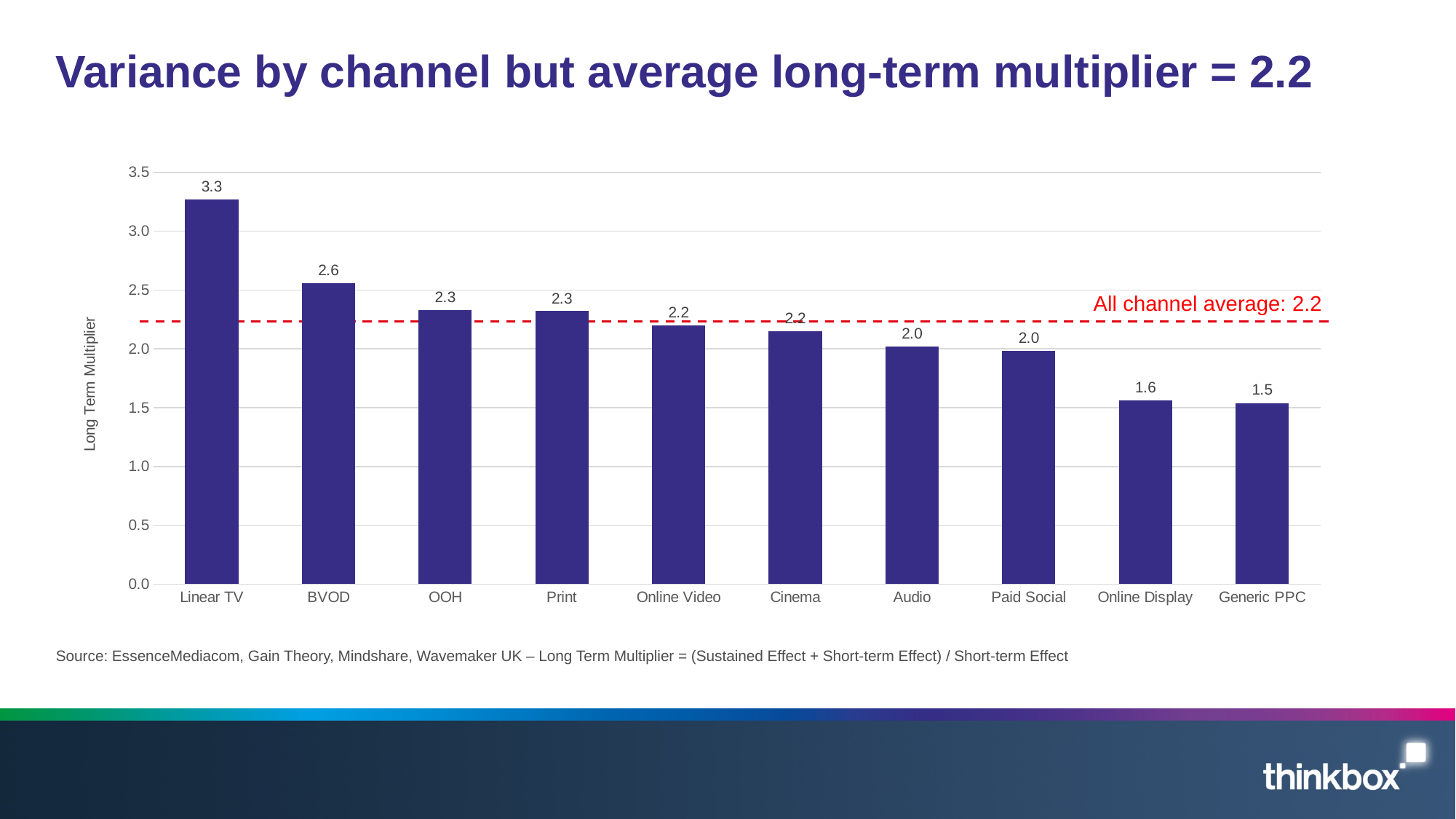
Which channel has the lowest long term multiplier? Generic PPC What is the long term multiplier for Online Display? 1.6 What is the long term multiplier for Linear TV? 3.3 Which channel has the highest long term multiplier? Linear TV What is the difference between the long term multiplier for Linear TV and BVOD? 0.7 What is the long term multiplier for Generic PPC? 1.5 What kind of chart is shown on the slide? Bar chart Which has a larger long term multiplier, BVOD or Audio? BVOD How many channels are shown on the chart? 10 Is the value for Paid Social greater or less than 2.5? less What is the long term multiplier for BVOD? 2.6 What value does the red dashed line on the chart represent? 2.2